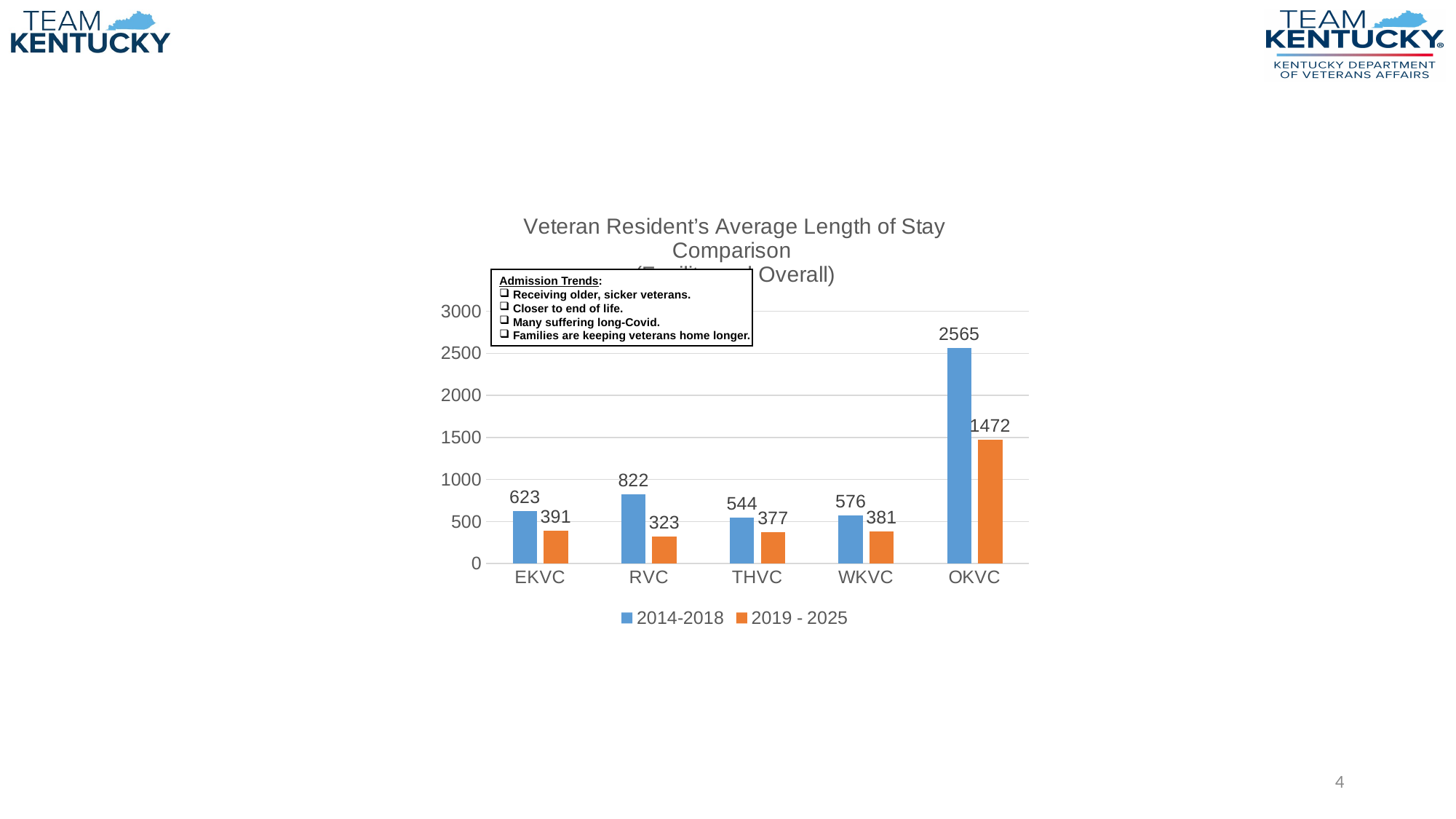
How many series does the legend list? 2 What is the 2014-2018 value for OKVC? 2565 Which facility has the lowest 2019 - 2025 value? RVC Which colour represents the 2019 - 2025 series? Orange What is the 2019 - 2025 value for RVC? 323 How many facilities are shown on the x axis? 5 What is the difference between the 2014-2018 and 2019 - 2025 values for EKVC? 232 What is the 2014-2018 value for THVC? 544 Which facility has the highest 2014-2018 value? OKVC Which is larger for RVC: the 2014-2018 value or the 2019 - 2025 value? 2014-2018 What is the 2019 - 2025 value for WKVC? 381 What kind of chart is shown on the slide? Bar chart